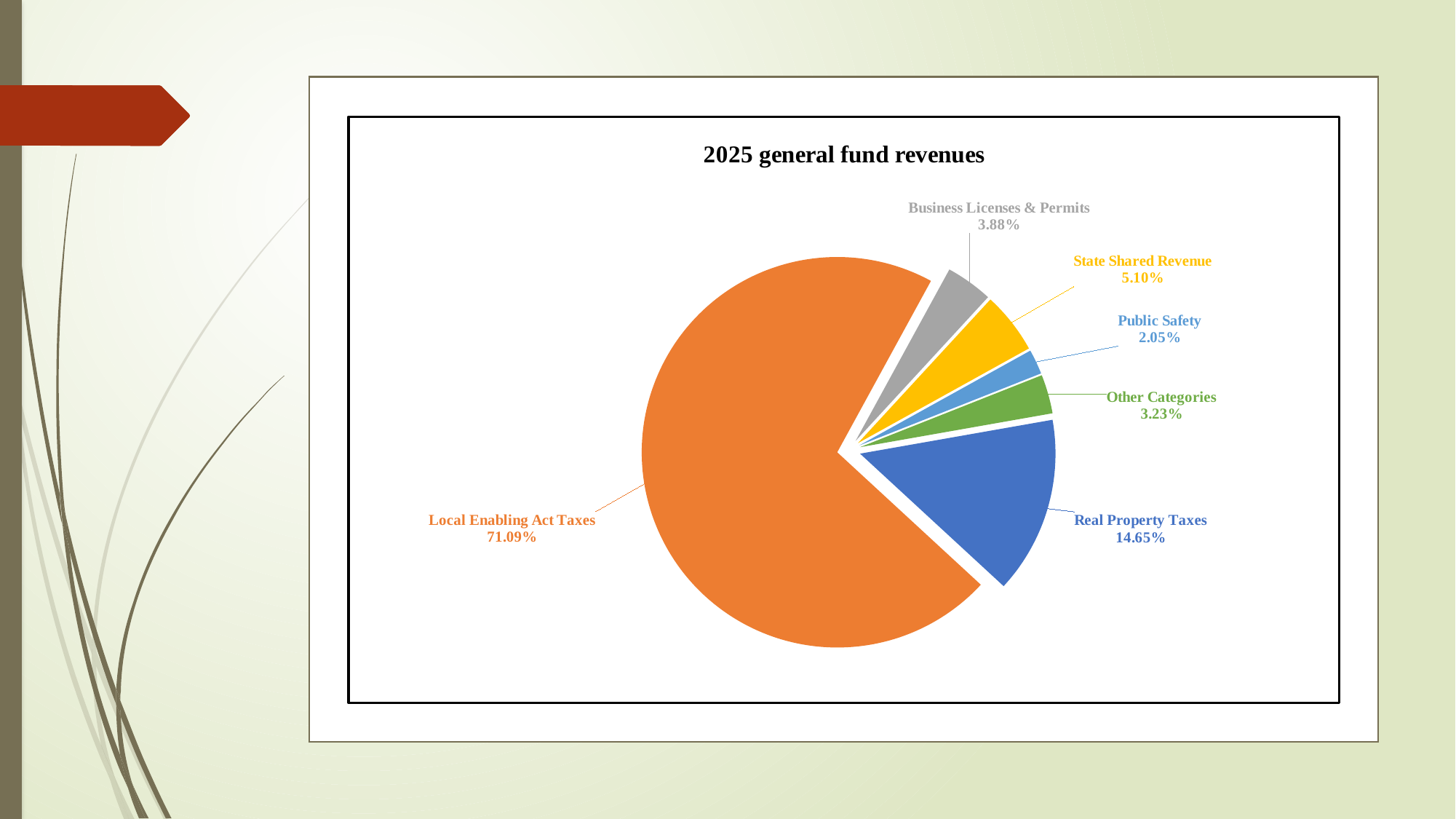
What percentage is shown for Public Safety? 2.05% What percentage is shown for Business Licenses & Permits? 3.88% What is the difference in percentage points between Real Property Taxes and State Shared Revenue? 9.55 What is the title of the chart? 2025 general fund revenues How many categories are shown in the pie chart? 6 What share of 2025 general fund revenues comes from Local Enabling Act Taxes? 71.09% Which category has the largest share of 2025 general fund revenues? Local Enabling Act Taxes Which category has the smallest share of 2025 general fund revenues? Public Safety What share of 2025 general fund revenues comes from Real Property Taxes? 14.65% Which is larger, the share for Other Categories or the share for Business Licenses & Permits? Business Licenses & Permits What kind of chart is shown on the slide? Pie chart What percentage is shown for State Shared Revenue? 5.10%